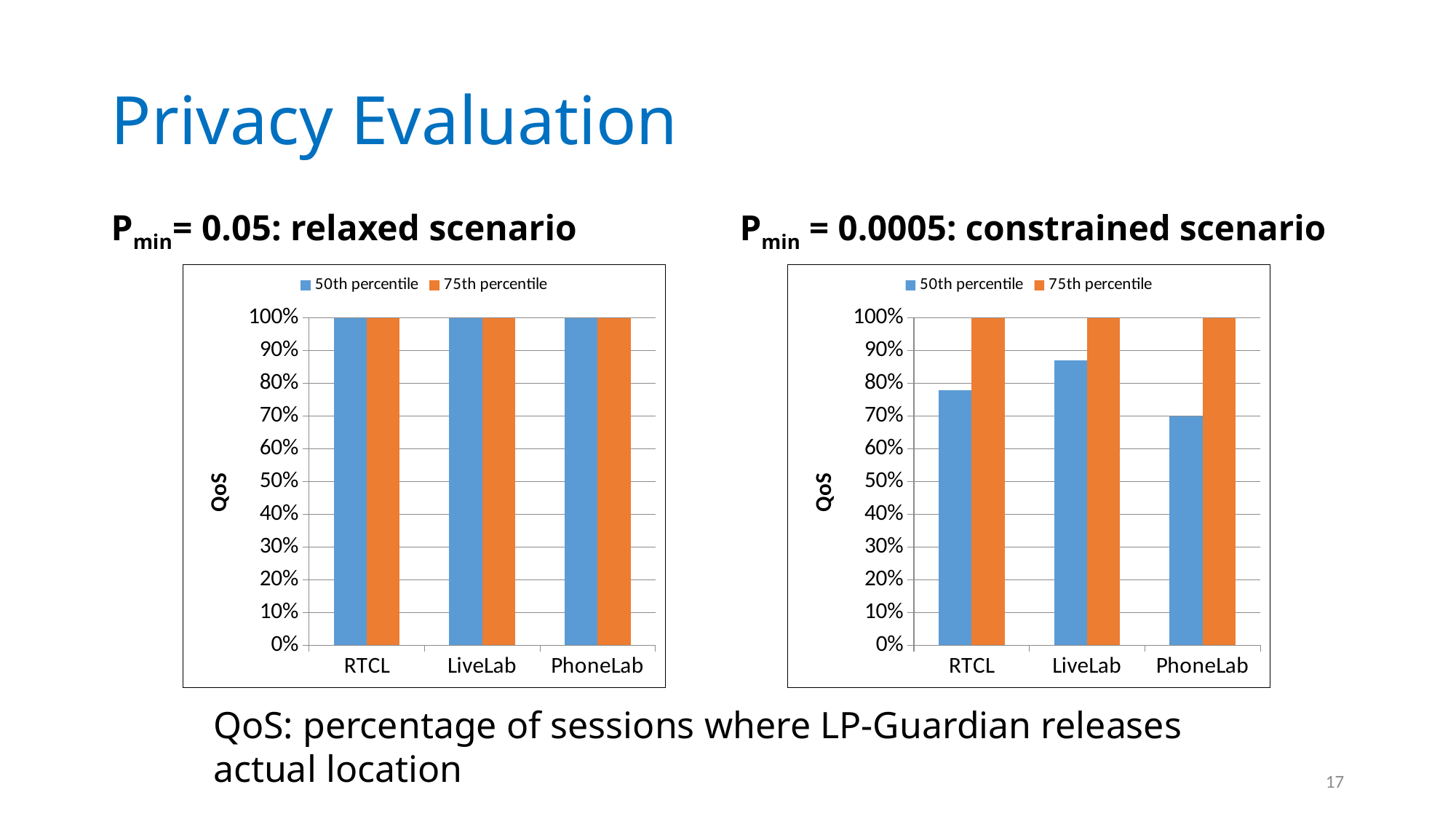
In the 'Pmin = 0.05: relaxed scenario' chart, what is the 50th percentile QoS value for RTCL? 100% In the 'Pmin = 0.0005: constrained scenario' chart, which category has the highest 50th percentile value? LiveLab In the 'Pmin = 0.0005: constrained scenario' chart, which is larger: the 50th percentile value for RTCL or for PhoneLab? RTCL What is the label on the y axis of the 'Pmin = 0.05: relaxed scenario' chart? QoS In the 'Pmin = 0.0005: constrained scenario' chart, how many series does the legend list? 2 In the 'Pmin = 0.0005: constrained scenario' chart, is the 50th percentile value for PhoneLab greater or less than 80%? less In the 'Pmin = 0.0005: constrained scenario' chart, which category has the lowest 50th percentile value? PhoneLab In the 'Pmin = 0.0005: constrained scenario' chart, what is the 75th percentile QoS value for LiveLab? 100% In the 'Pmin = 0.05: relaxed scenario' chart, how many categories are shown on the x axis? 3 What kind of chart is shown under the 'Pmin = 0.05: relaxed scenario' heading? bar chart In the 'Pmin = 0.0005: constrained scenario' chart, is the 50th percentile value for RTCL greater or less than 70%? greater In the 'Pmin = 0.0005: constrained scenario' chart, is the 50th percentile value for LiveLab greater or less than 80%? greater